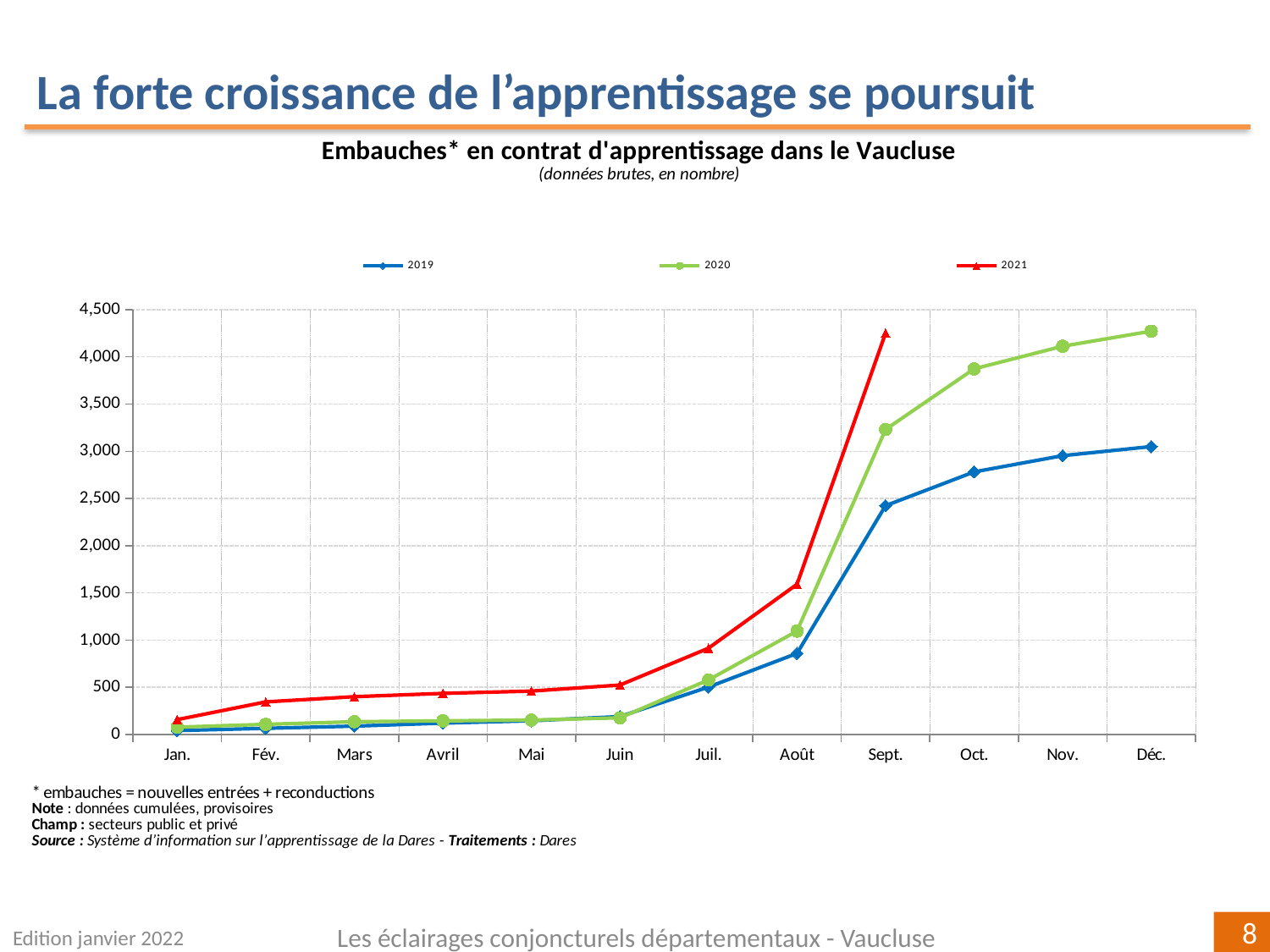
Is the value for 2020 in Déc. greater or less than 4,000? greater What is the last month for which the 2021 series has a data point? Sept. How many months are shown on the x axis? 12 How many series does the legend list? 3 Is the value for 2020 in Oct. greater or less than 3,500? greater Is the value for 2021 in Août greater or less than 1,000? greater Do the values for the 2019 series rise or fall from Jan. to Déc.? rise In Sept., which series has the higher value, 2020 or 2021? 2021 What kind of chart is shown on the slide? line chart In Déc., which series has the higher value, 2019 or 2020? 2020